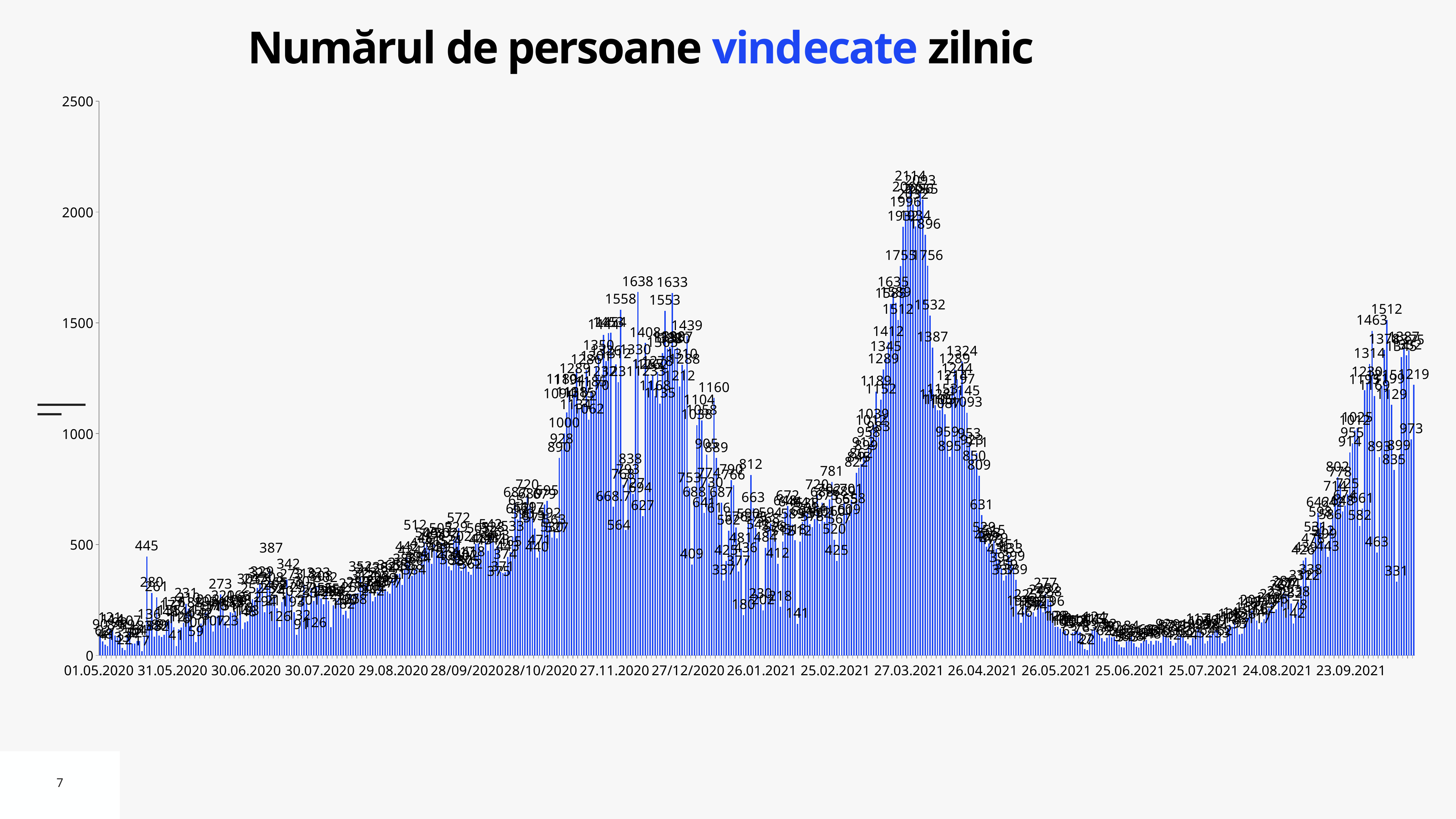
What is the highest value labeled in the wave around 27.11.2020? 1638 What is the first date label on the horizontal axis? 01.05.2020 What is the difference between the two tallest labeled bars of the late-2020 wave, 1638 and 1633? 5 Do the values rise or fall between 24.08.2021 and 23.09.2021? rise Is the tallest bar on the chart greater or less than 2000? greater What is the topmost tick value on the vertical axis? 2500 What kind of chart is shown on the slide? bar chart What is the highest value labeled in the wave at the right end of the chart, after 23.09.2021? 1512 Which wave has the higher peak: the one around 27.11.2020 or the one around 27.03.2021? 27.03.2021 What is the highest value labeled on the chart? 2114 What is the title of the chart? Numărul de persoane vindecate zilnic Are the values around 25.06.2021 greater or less than 500? less